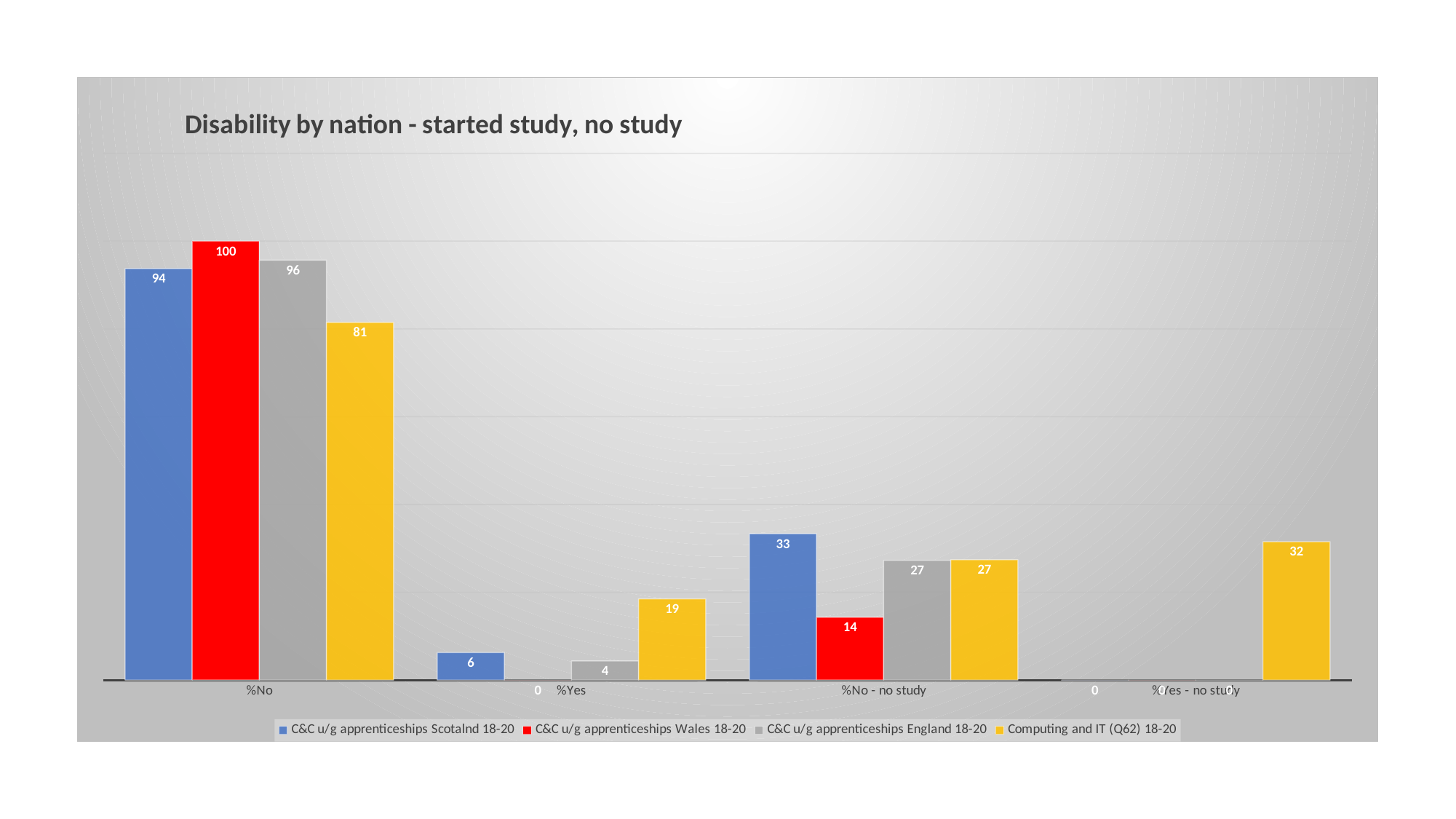
What is the value for Computing and IT (Q62) 18-20 in the %Yes category? 19 What is the value for Computing and IT (Q62) 18-20 in the %Yes - no study category? 32 What is the value for C&C u/g apprenticeships Wales 18-20 in the %No category? 100 How many series does the legend list? 4 What is the difference between the C&C u/g apprenticeships England 18-20 value and the Computing and IT (Q62) 18-20 value in the %No category? 15 What is the value for C&C u/g apprenticeships Scotalnd 18-20 in the %No - no study category? 33 How many categories are shown on the x axis? 4 What kind of chart is shown on the slide? Bar chart Which series has the highest value in the %No category? C&C u/g apprenticeships Wales 18-20 Which series has the lowest value in the %No - no study category? C&C u/g apprenticeships Wales 18-20 In the %Yes category, which is larger: the value for C&C u/g apprenticeships Scotalnd 18-20 or for C&C u/g apprenticeships England 18-20? C&C u/g apprenticeships Scotalnd 18-20 What is the title of the chart? Disability by nation - started study, no study